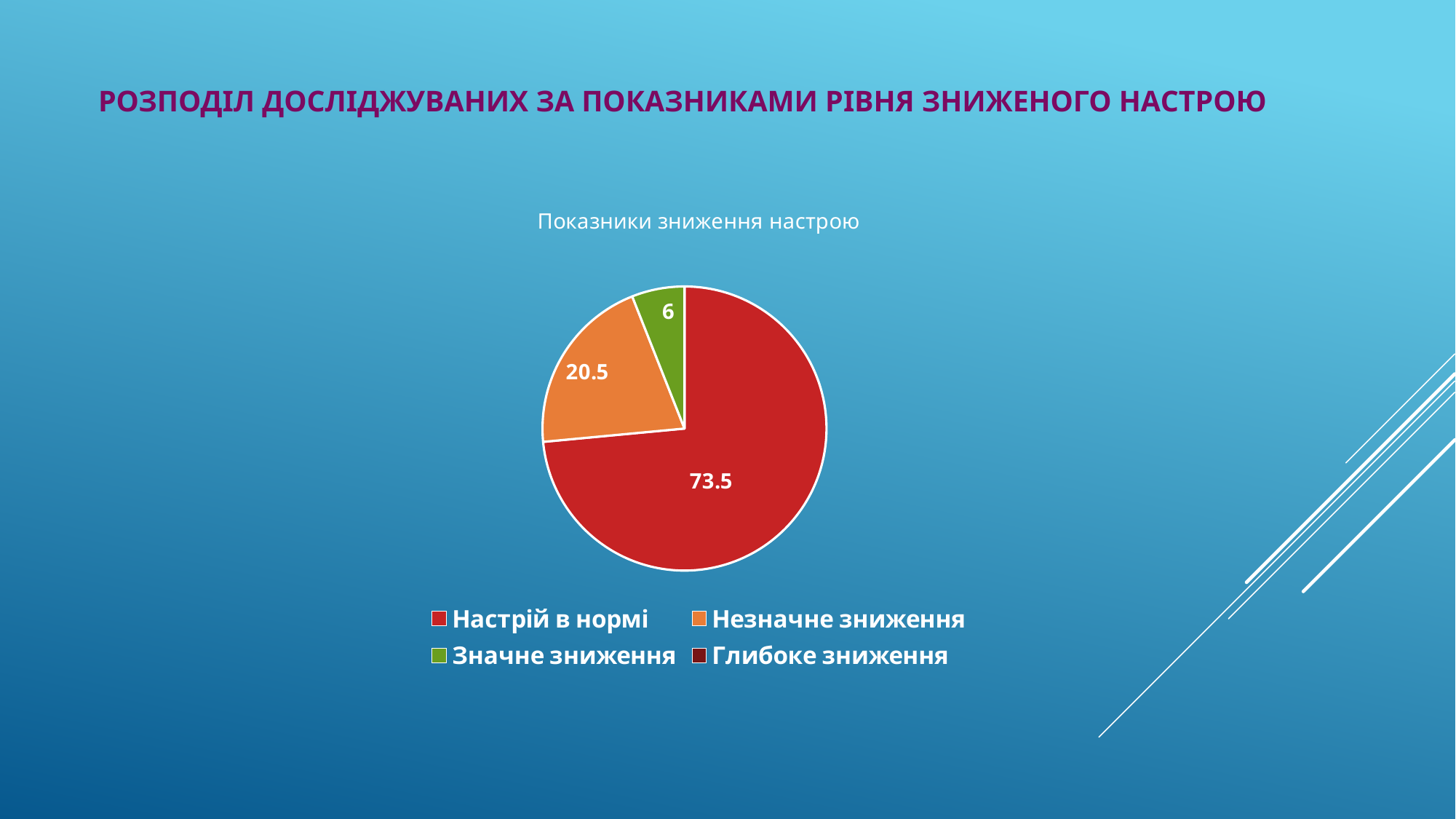
What is the difference between the values for Незначне зниження and Значне зниження? 14.5 What is the value for Значне зниження? 6 What is the title of the chart? Показники зниження настрою What is the value for Настрій в нормі? 73.5 What is the difference between the values for Настрій в нормі and Незначне зниження? 53 What colour is the slice for Незначне зниження? orange Which category has the largest slice of the pie? Настрій в нормі What share of the pie does Настрій в нормі take, given the printed values sum to 100? 73.5 How many categories does the legend list? 4 What is the value for Незначне зниження? 20.5 Which is larger, the value for Незначне зниження or the value for Значне зниження? Незначне зниження What type of chart is shown on the slide? pie chart